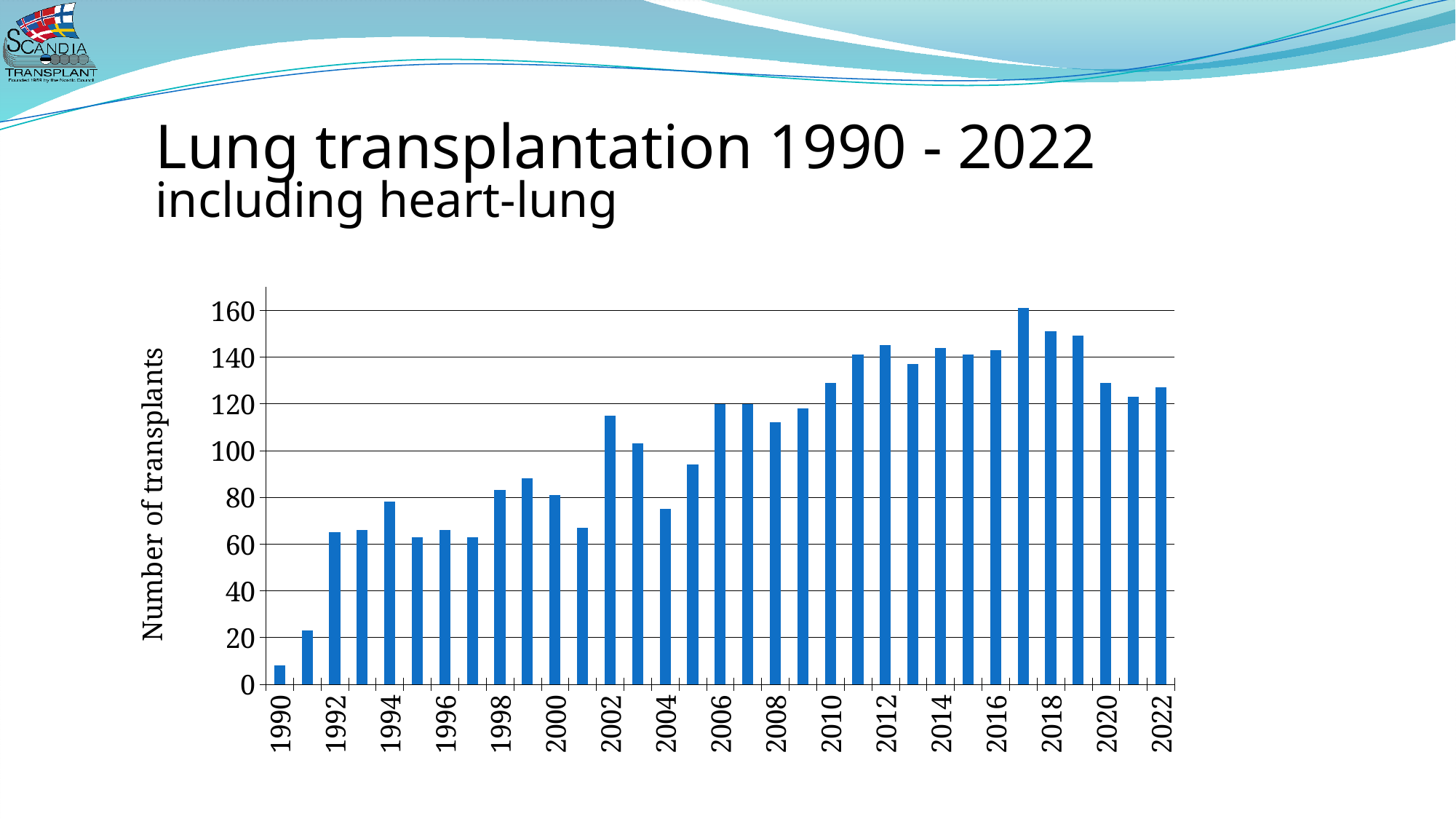
Is the value for 2002 greater or less than 100? greater Which year has the lowest number of transplants? 1990 Is the value for 1990 greater or less than 20? less Is the value for 2004 greater or less than 80? less What is the label on the vertical axis? Number of transplants Which year has more transplants, 2017 or 2022? 2017 What kind of chart is shown on the slide? bar chart How many years (bars) are plotted in the chart? 33 Which year has the highest number of transplants? 2017 Which year has more transplants, 2002 or 2003? 2002